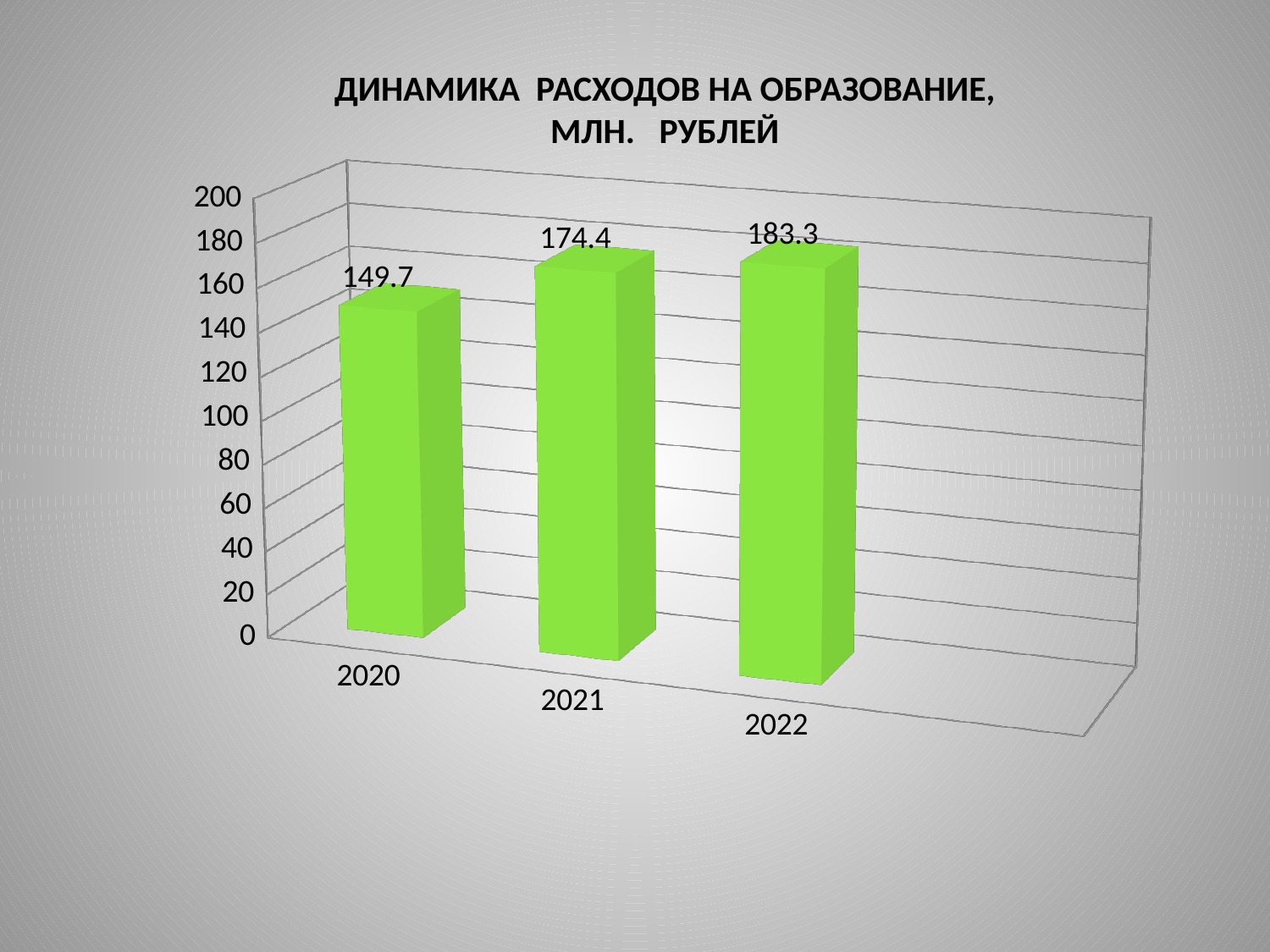
What is the value for 2022? 183.3 What is the value for 2020? 149.7 Which year has the lowest value? 2020 Do the values rise or fall from 2020 to 2022? rise What is the difference between the values for 2021 and 2020? 24.7 Which year has the highest value? 2022 Which is larger, the value for 2021 or the value for 2022? 2022 What kind of chart is this? bar chart Is the value for 2020 greater or less than 160? less How many years are shown on the chart? 3 What is the value for 2021? 174.4 What is the difference between the values for 2022 and 2020? 33.6